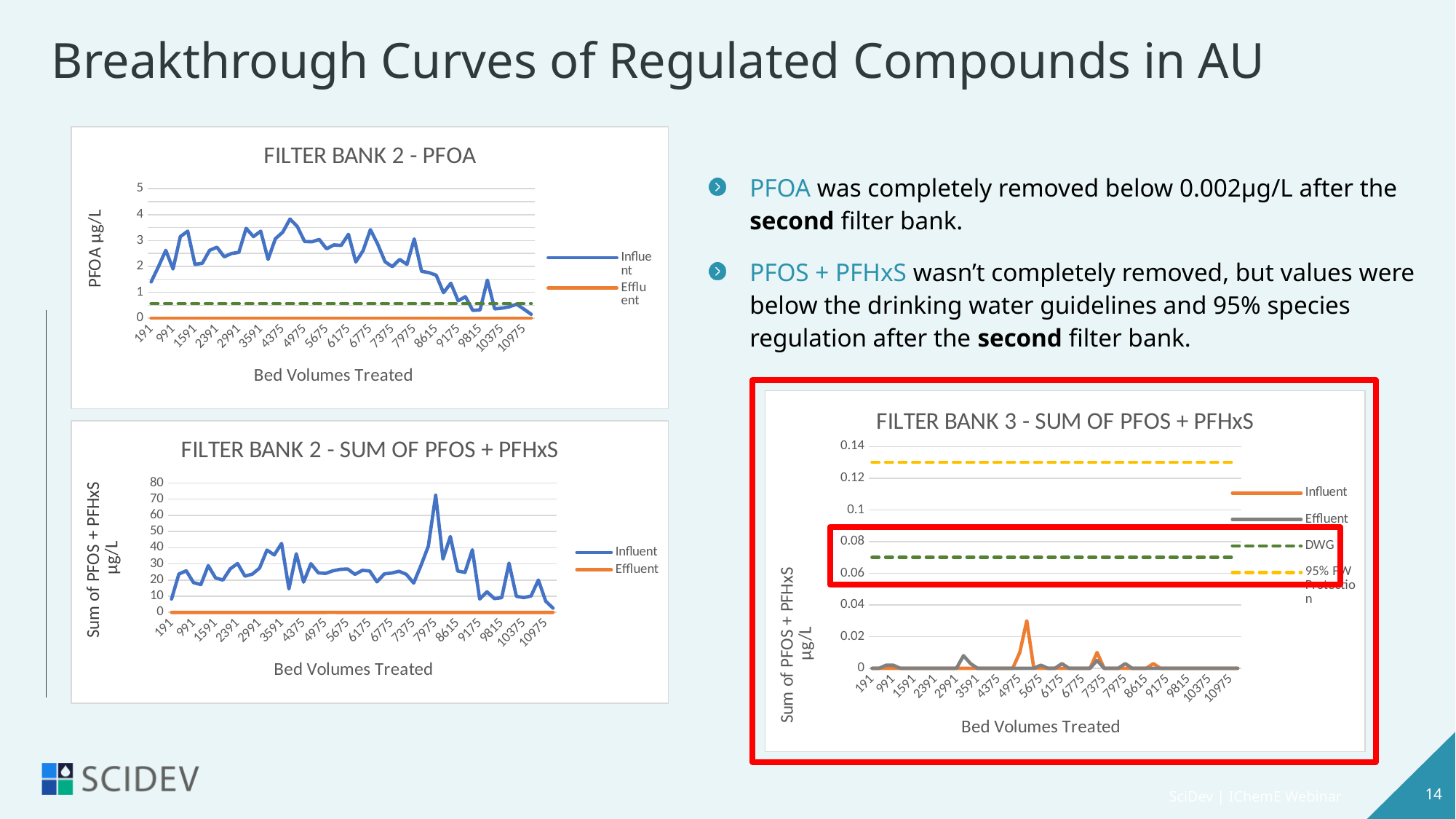
How many series does the legend of the FILTER BANK 2 - PFOA chart list? 2 In the FILTER BANK 3 - SUM OF PFOS + PFHxS chart, is the Influent peak near 4975 bed volumes greater or less than 0.04? less What is the y-axis title of the FILTER BANK 2 - PFOA chart? PFOA µg/L How many series does the legend of the FILTER BANK 3 - SUM OF PFOS + PFHxS chart list? 4 In the FILTER BANK 2 - SUM OF PFOS + PFHxS chart, which series is larger at 7975 bed volumes, Influent or Effluent? Influent In the FILTER BANK 3 - SUM OF PFOS + PFHxS chart, is the Influent peak near 4975 bed volumes greater or less than 0.02? greater In the FILTER BANK 2 - SUM OF PFOS + PFHxS chart, is the peak Influent value near 7975 bed volumes greater or less than 60? greater In the FILTER BANK 2 - PFOA chart, does the Influent line generally rise or fall from 7975 to 10975 bed volumes? fall What kind of chart is the FILTER BANK 2 - PFOA chart? line chart What is the x-axis title of the FILTER BANK 2 - PFOA chart? Bed Volumes Treated